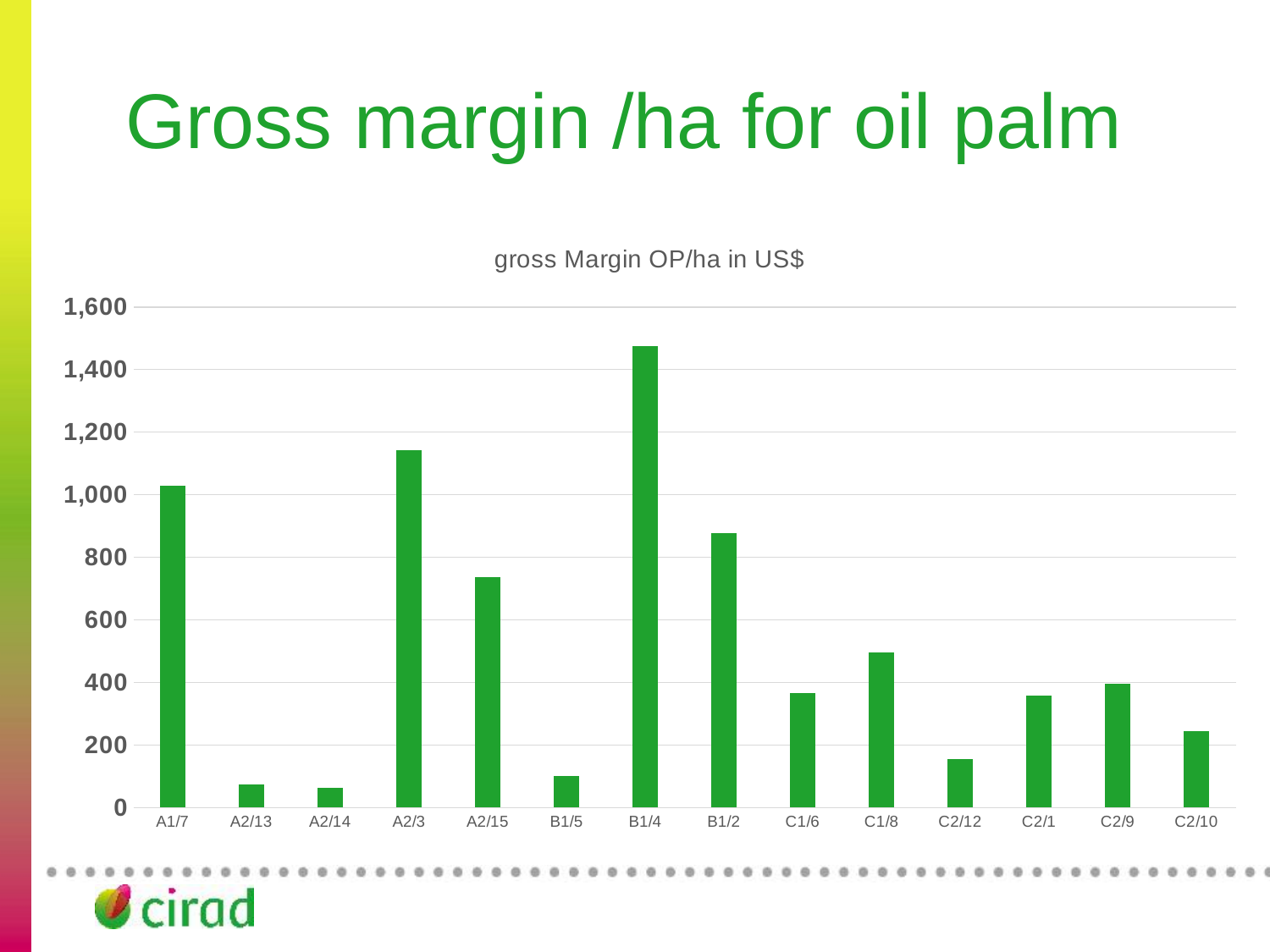
Which is larger, the value for C1/8 or the value for C1/6? C1/8 Is the value for C2/12 greater or less than 200? less Is the value for B1/4 greater or less than 1,400? greater Which is larger, the value for A2/3 or the value for A1/7? A2/3 Which is larger, the value for B1/2 or the value for A2/15? B1/2 Which category has the highest gross margin? B1/4 How many categories are plotted on the x axis? 14 Is the value for C1/8 greater or less than 400? greater What type of chart is shown on the slide? bar chart What is the title of the chart? gross Margin OP/ha in US$